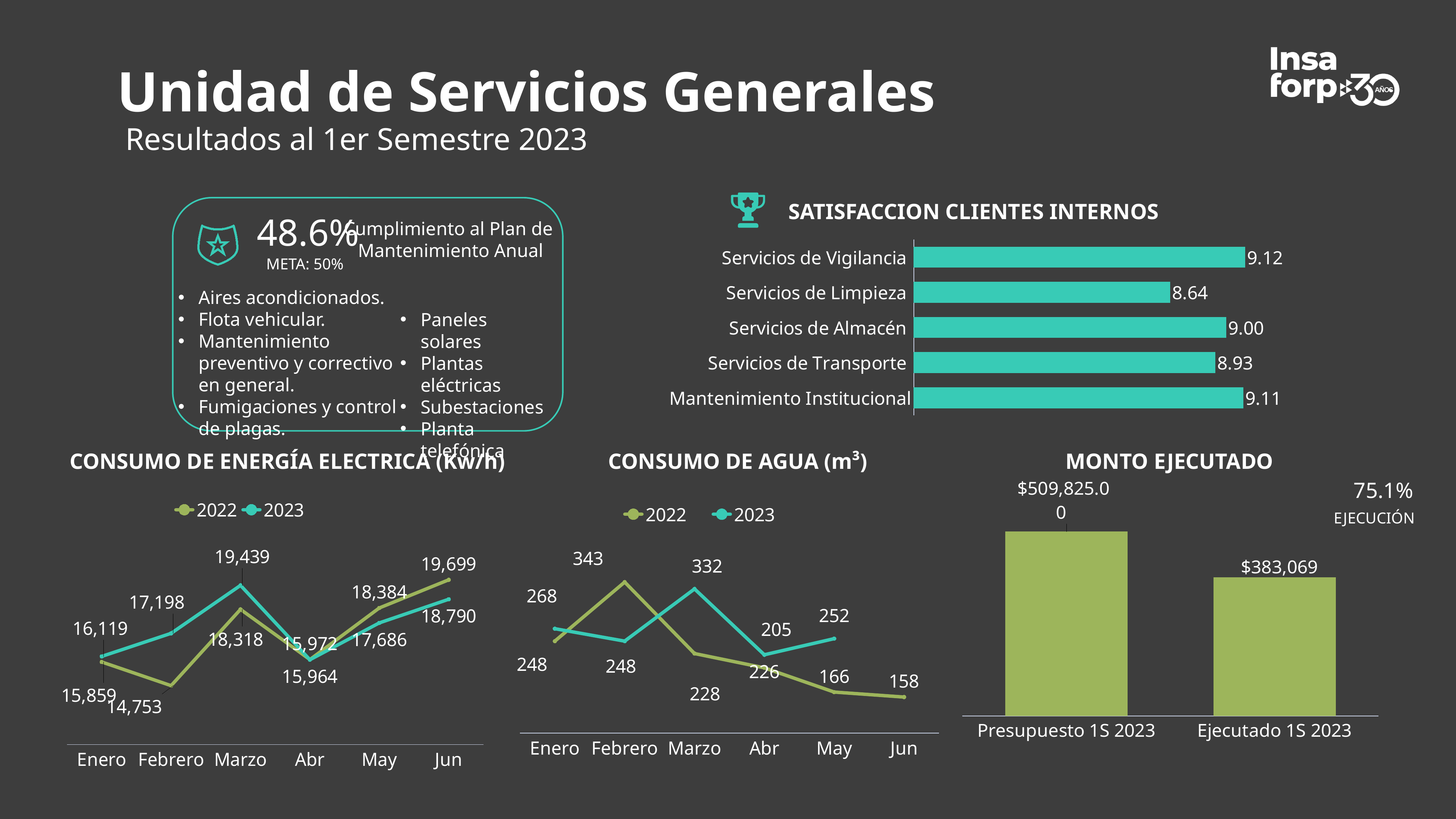
In the MONTO EJECUTADO chart, what is the value for Ejecutado 1S 2023? $383,069 In the CONSUMO DE AGUA (m³) chart, how many series does the legend list? 2 In the SATISFACCION CLIENTES INTERNOS chart, which category has the highest value? Servicios de Vigilancia In the CONSUMO DE ENERGÍA ELECTRICA (Kw/h) chart, what is the 2022 value for Febrero? 14,753 In the CONSUMO DE AGUA (m³) chart, what is the 2022 value for Febrero? 343 In the CONSUMO DE AGUA (m³) chart, what is the difference between the 2023 value and the 2022 value for Marzo? 104 In the CONSUMO DE ENERGÍA ELECTRICA (Kw/h) chart, what is the 2023 value for Marzo? 19,439 What kind of chart is the MONTO EJECUTADO chart? Bar chart In the CONSUMO DE ENERGÍA ELECTRICA (Kw/h) chart, which is larger in Jun, the 2022 value or the 2023 value? 2022 In the SATISFACCION CLIENTES INTERNOS chart, what is the value for Servicios de Limpieza? 8.64 In the SATISFACCION CLIENTES INTERNOS chart, how many categories are shown? 5 In the SATISFACCION CLIENTES INTERNOS chart, which category has the lowest value? Servicios de Limpieza